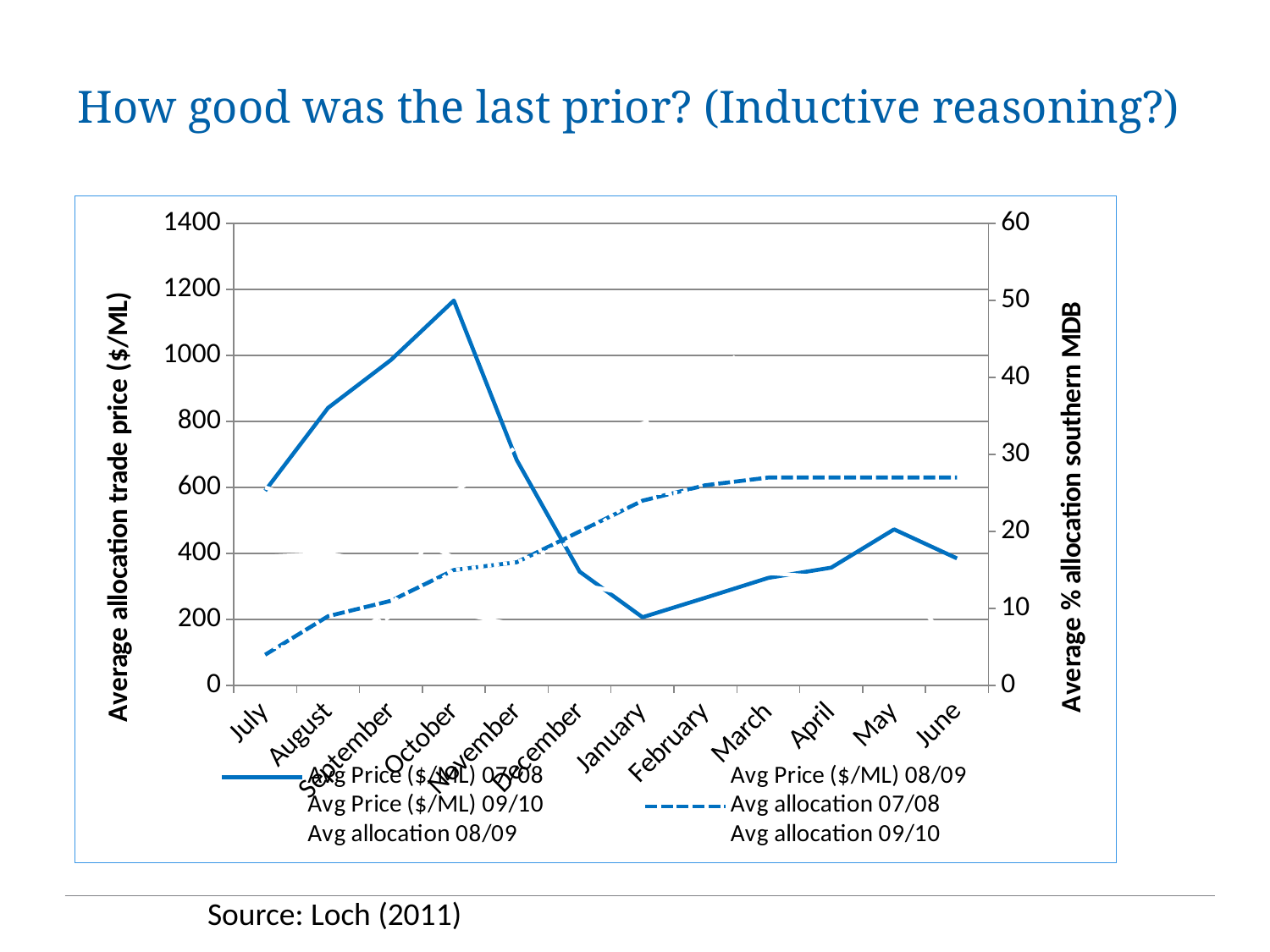
What is the title of the chart's left vertical axis? Average allocation trade price ($/ML) Is the Avg Price ($/ML) 07/08 value for February greater or less than 400? less Which month has the larger Avg Price ($/ML) 07/08 value, August or May? August How many series does the chart's legend list? 6 What kind of chart is shown on the slide? Line chart How many months are shown along the x axis of the chart? 12 Is the Avg Price ($/ML) 07/08 value for October greater or less than 1000? greater In which month does the solid Avg Price ($/ML) 07/08 line reach its lowest value? January In which month does the solid Avg Price ($/ML) 07/08 line reach its highest value? October Does the dashed Avg allocation 07/08 line rise or fall from July to March? Rise Is the Avg allocation 07/08 value for July greater or less than 10 on the right axis? less Does the solid Avg Price ($/ML) 07/08 line rise or fall from October to February? Fall